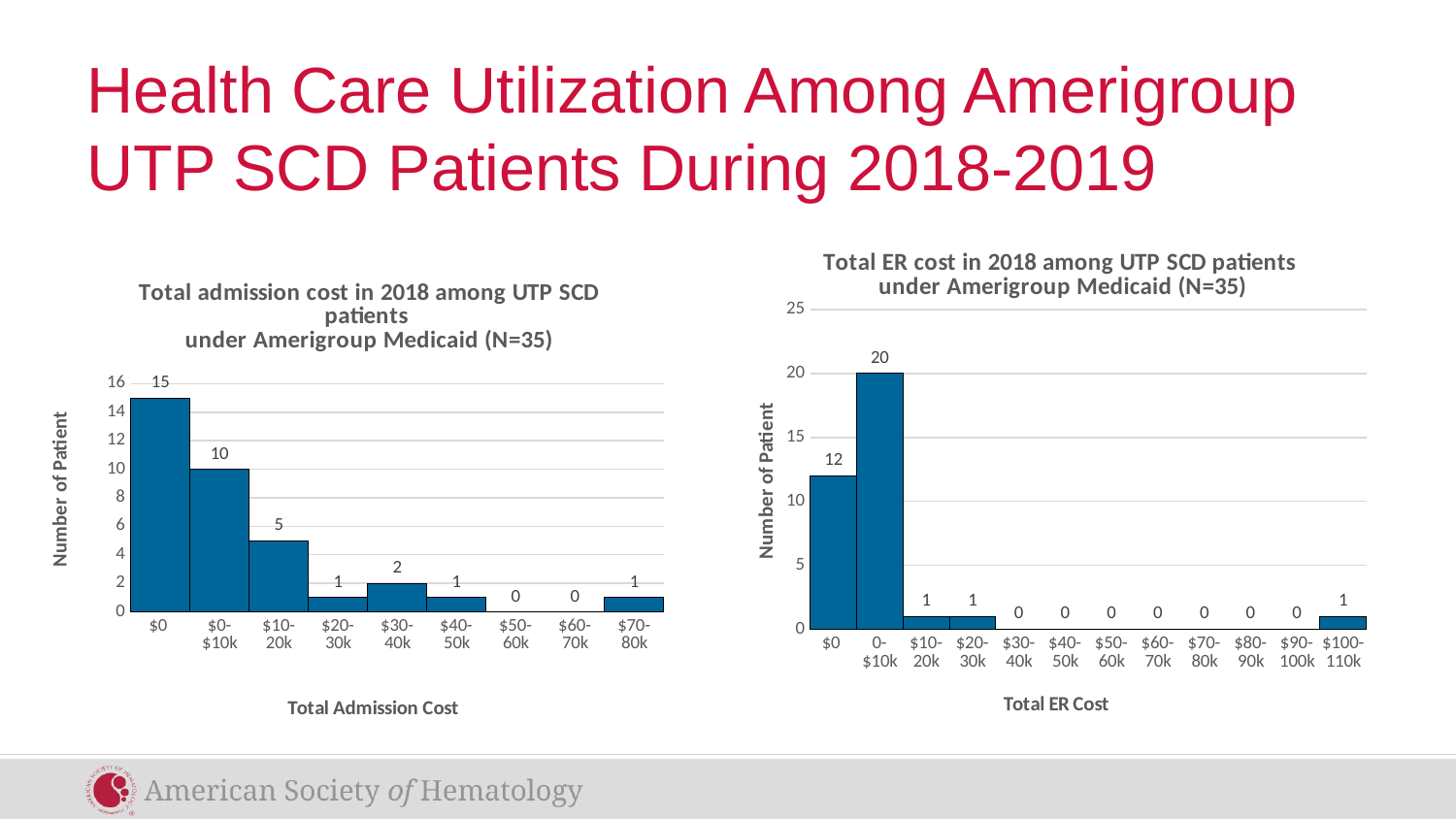
In the 'Total admission cost' chart on the left, how many patients are in the $0 category? 15 What type of chart is the 'Total ER cost' chart on the right? Bar chart In the 'Total ER cost' chart on the right, how many cost categories are shown on the x axis? 12 In the 'Total admission cost' chart on the left, how many cost categories are shown on the x axis? 9 In the 'Total admission cost' chart on the left, how many patients are in the $10-20k category? 5 In the 'Total ER cost' chart on the right, which cost category has the highest number of patients? 0-$10k Which is larger: the number of patients in the $0 category of the 'Total admission cost' chart or the $0 category of the 'Total ER cost' chart? Total admission cost chart In the 'Total ER cost' chart on the right, what is the difference in number of patients between the 0-$10k and $0 categories? 8 In the 'Total ER cost' chart on the right, how many patients are in the $0 category? 12 In the 'Total admission cost' chart on the left, what is the difference in number of patients between the $0 and $0-$10k categories? 5 In the 'Total admission cost' chart on the left, which cost category has the highest number of patients? $0 In the 'Total ER cost' chart on the right, how many patients are in the 0-$10k category? 20